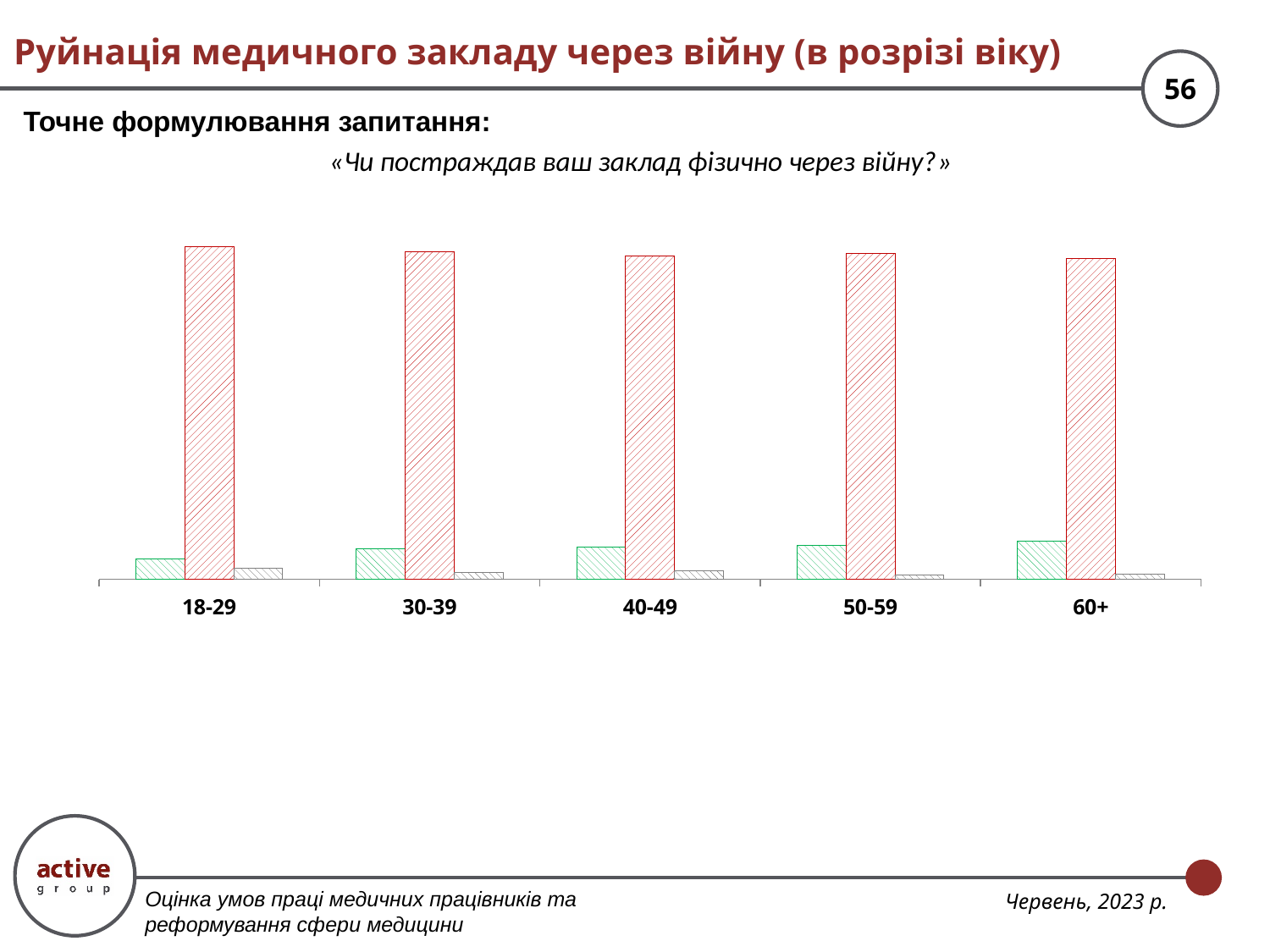
In the 50-59 age group, which of the three bars is the shortest? the grey hatched bar What kind of chart is shown on the slide? bar chart How many age groups are shown on the x axis of the chart? 5 In the 60+ age group, which bar is taller: the green hatched bar or the grey hatched bar? the green hatched bar Which age group has the shortest green hatched bar? 18-29 Do the green hatched bars rise or fall moving from the 18-29 group to the 60+ group? rise In the 18-29 age group, which bar is taller: the red hatched bar or the green hatched bar? the red hatched bar What is the title of the slide containing the chart? Руйнація медичного закладу через війну (в розрізі віку) Which bar is the tallest in every age group? the red hatched bar Which age group has the tallest green hatched bar? 60+ How many bars are plotted for each age group? 3 What is the last age group label on the x axis? 60+